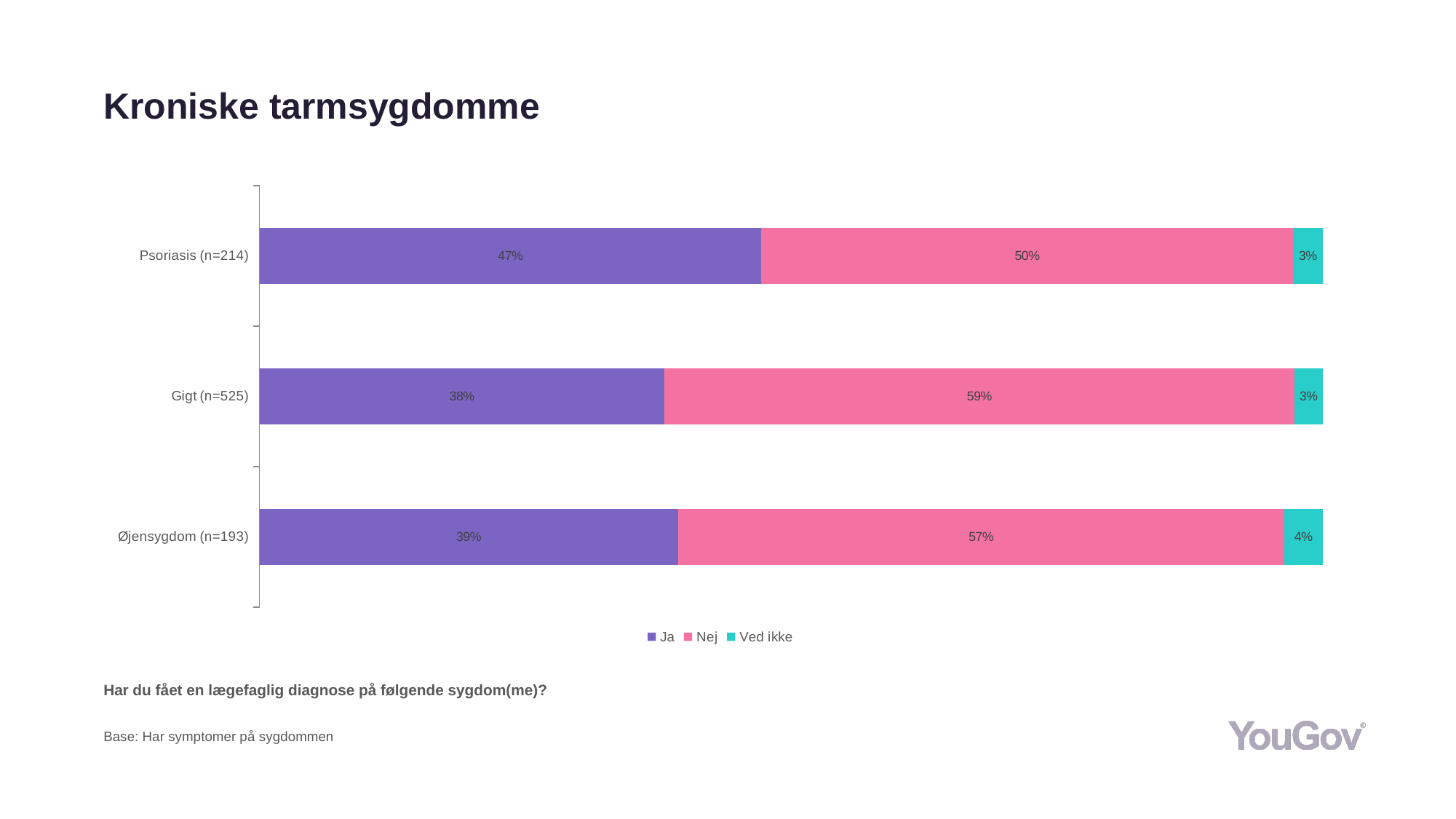
What is the difference between the "Nej" share for Gigt (n=525) and for Psoriasis (n=214)? 9 percentage points What percentage answered "Nej" for Gigt (n=525)? 59% How many series does the legend list? 3 What kind of chart is shown on the slide? Stacked bar chart What percentage answered "Ja" for Psoriasis (n=214)? 47% Which category has the lowest "Ja" share? Gigt (n=525) How many categories are shown on the chart? 3 Which category has the highest "Ja" share? Psoriasis (n=214) What percentage answered "Ved ikke" for Øjensygdom (n=193)? 4% Which is larger: the "Ja" share for Psoriasis (n=214) or for Øjensygdom (n=193)? Psoriasis (n=214) What is the title of the slide? Kroniske tarmsygdomme What is the total of the stacked bar for Gigt (n=525)? 100%